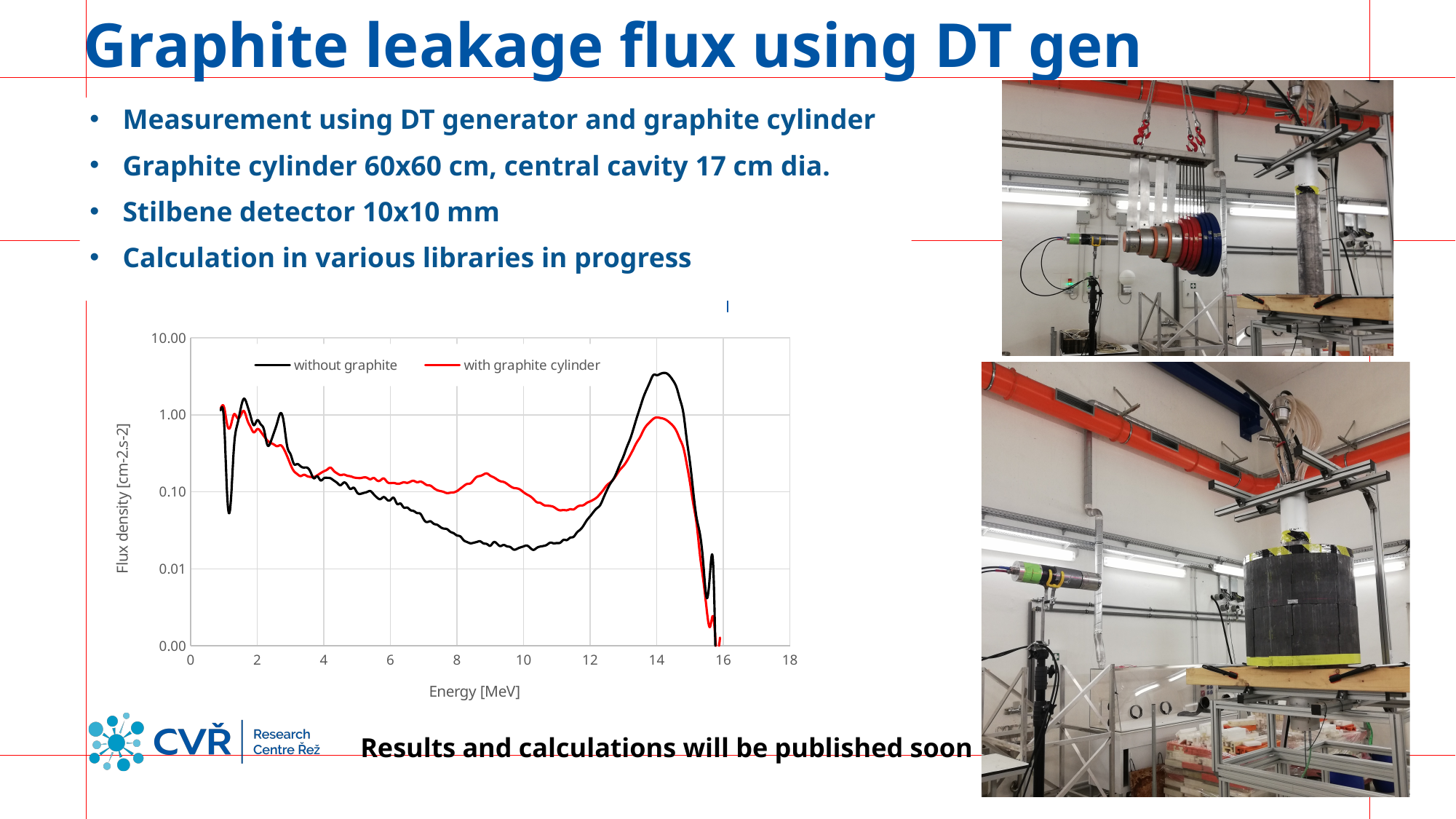
What kind of chart is shown on the slide? line chart Between 14 MeV and 16 MeV, does the 'with graphite cylinder' series rise or fall? fall Is the value of the 'with graphite cylinder' series at 4 MeV greater or less than 1.00? less At 10 MeV, which series has the higher flux density, 'without graphite' or 'with graphite cylinder'? with graphite cylinder Is the peak value of the 'without graphite' series near 14 MeV greater or less than 1.00? greater How many series does the chart legend list? 2 Is the value of the 'without graphite' series at 10 MeV greater or less than 0.10? less What is the x-axis title of the chart? Energy [MeV] At 14 MeV, which series has the higher flux density, 'without graphite' or 'with graphite cylinder'? without graphite Between 12 MeV and 14 MeV, does the 'without graphite' series rise or fall? rise What are the two series named in the chart legend? without graphite; with graphite cylinder